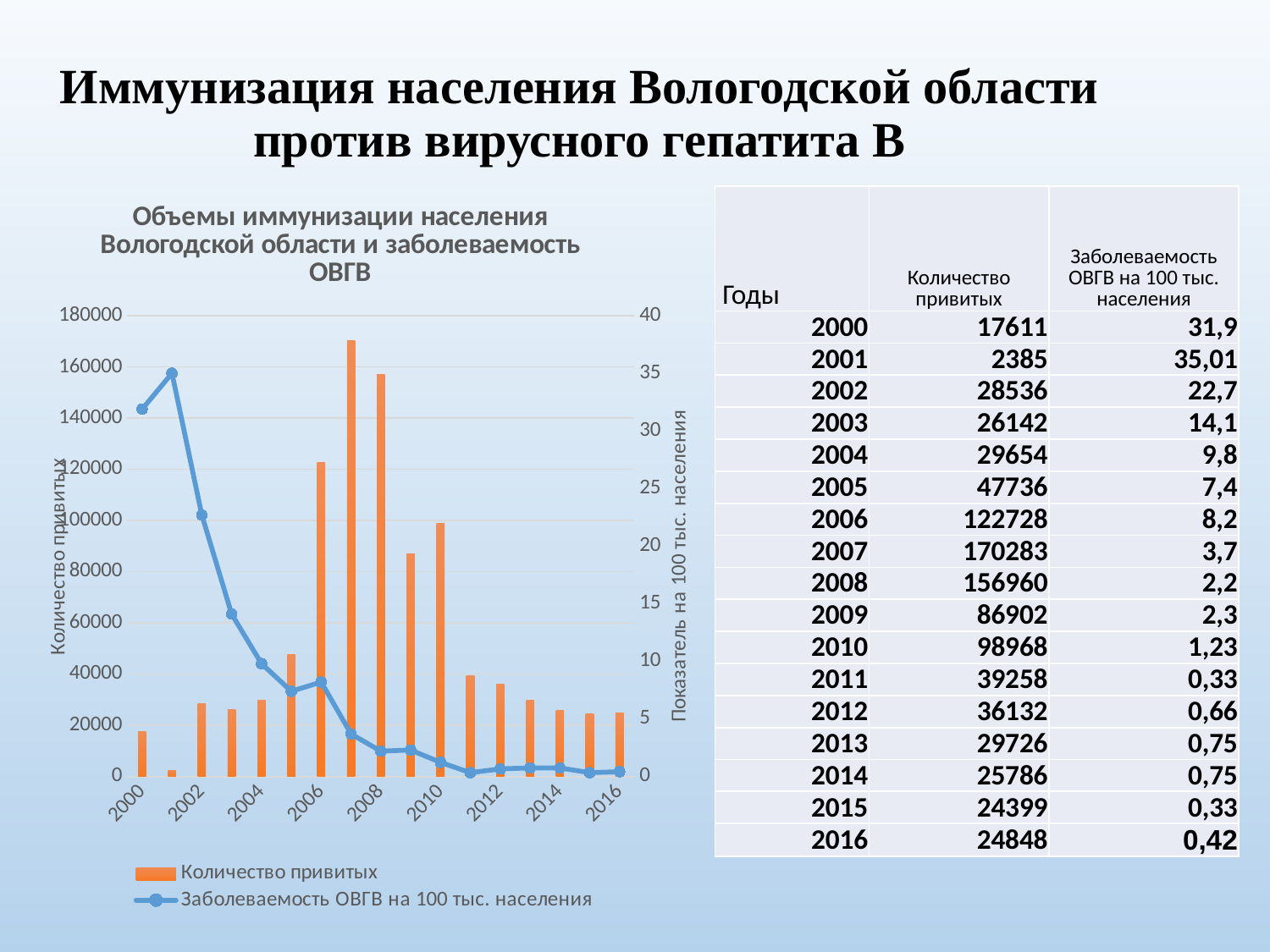
Which year has the highest incidence of ОВГВ per 100 thousand population? 2001 Which is larger: the number of vaccinated people in 2009 or in 2010? 2010 What kind of chart is shown on the slide? Combined bar and line chart What is the title of the chart? Объемы иммунизации населения Вологодской области и заболеваемость ОВГВ Which year has the lowest number of vaccinated people (Количество привитых)? 2001 What is the difference in the number of vaccinated people between 2007 and 2008? 13323 Does the incidence of ОВГВ per 100 thousand population generally rise or fall from 2001 to 2016? fall What is the number of vaccinated people in 2007? 170283 What is the incidence of ОВГВ per 100 thousand population in 2001? 35,01 Is the number of vaccinated people in 2006 greater or less than 120000? greater How many series does the chart legend list? 2 Which year has the highest number of vaccinated people (Количество привитых)? 2007